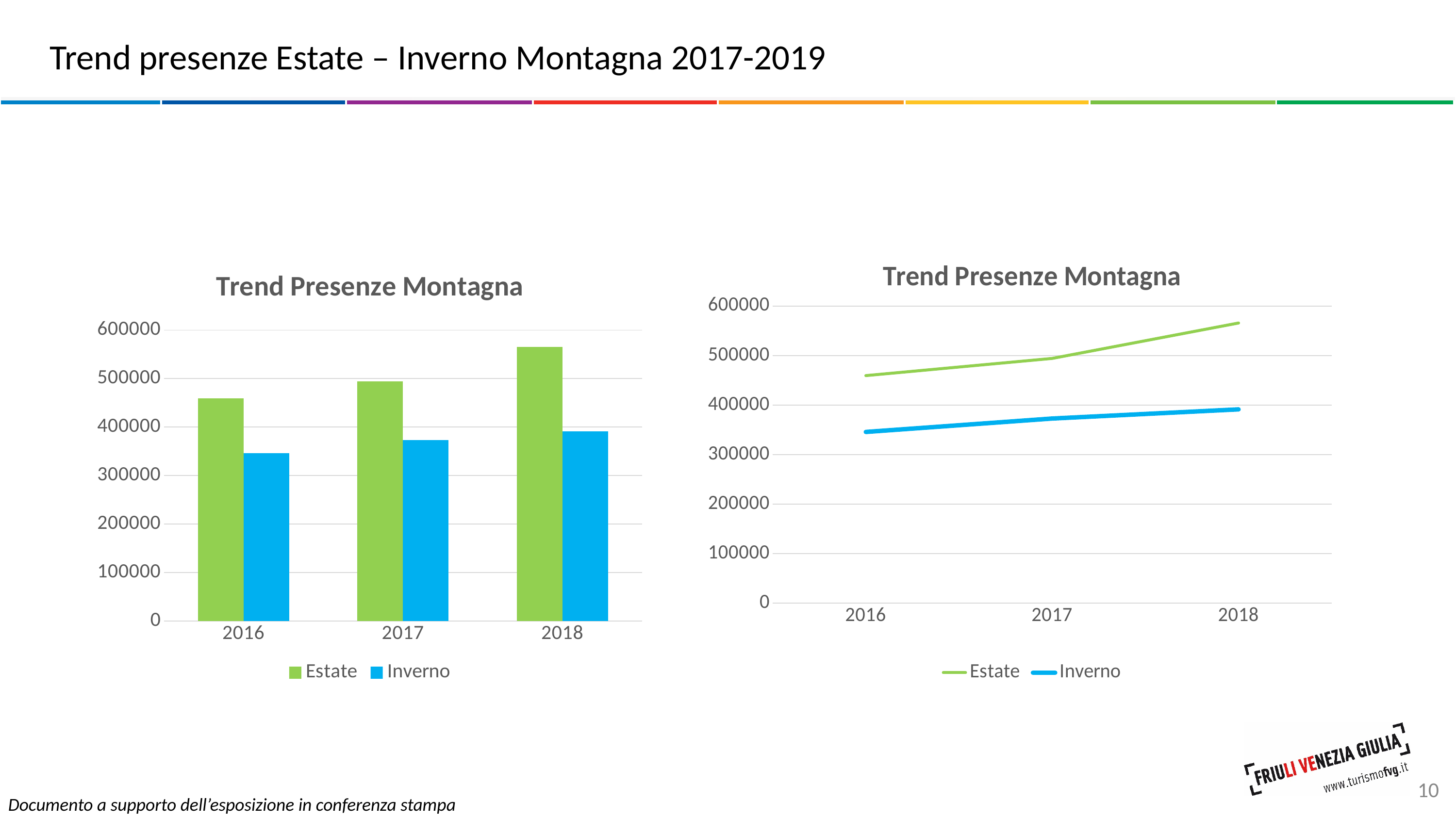
What kind of chart is the chart on the right of the slide? line chart In the bar chart on the left, how many series does the legend list? 2 In the bar chart on the left, is the Inverno value for 2016 greater or less than 400000? less In the line chart on the right, how many years are shown on the x axis? 3 In the bar chart on the left, which is larger in 2017, Estate or Inverno? Estate In the line chart on the right, which colour is used for the Estate line? green In the bar chart on the left, is the Estate value for 2018 greater or less than 500000? greater In the line chart on the right, do the Inverno values rise or fall from 2016 to 2018? rise What kind of chart is the chart on the left of the slide? bar chart In the line chart on the right, is the Estate value for 2016 greater or less than 500000? less In the bar chart on the left, which year has the highest Estate value? 2018 In the bar chart on the left, which year has the lowest Inverno value? 2016